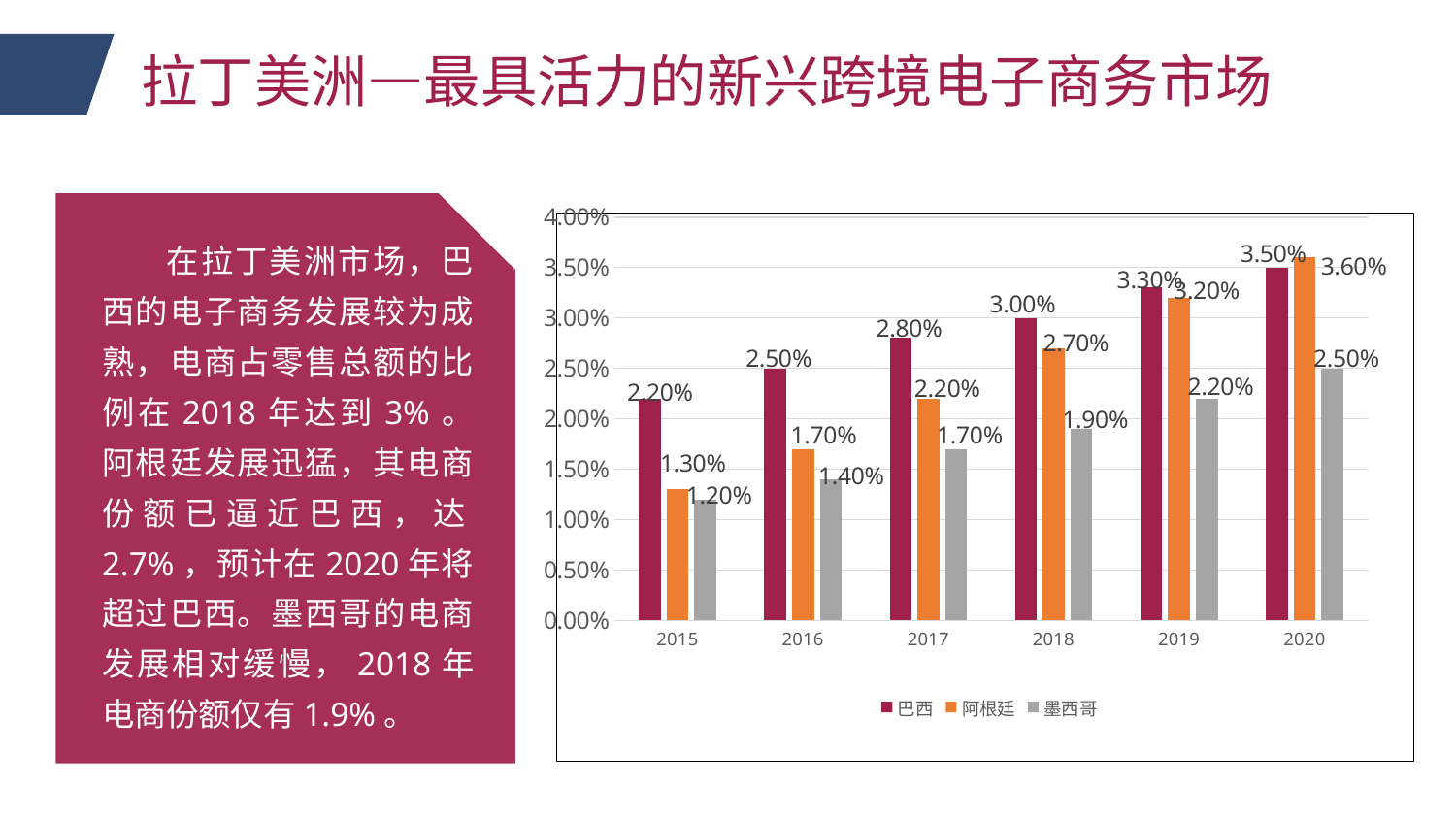
In which year is the value for 阿根廷 lowest? 2015 What is the value for 巴西 in 2018? 3.00% What kind of chart is shown on the slide? bar chart What is the value for 墨西哥 in 2015? 1.20% Which is larger in 2020, the value for 巴西 or the value for 阿根廷? 阿根廷 How many series does the legend list? 3 Do the values for 阿根廷 rise or fall from 2015 to 2020? rise What is the difference between the 巴西 and 墨西哥 values in 2017? 1.10% In which year is the value for 墨西哥 highest? 2020 How many years are shown on the x axis? 6 What is the value for 阿根廷 in 2020? 3.60% Which series is shown in orange in the legend? 阿根廷